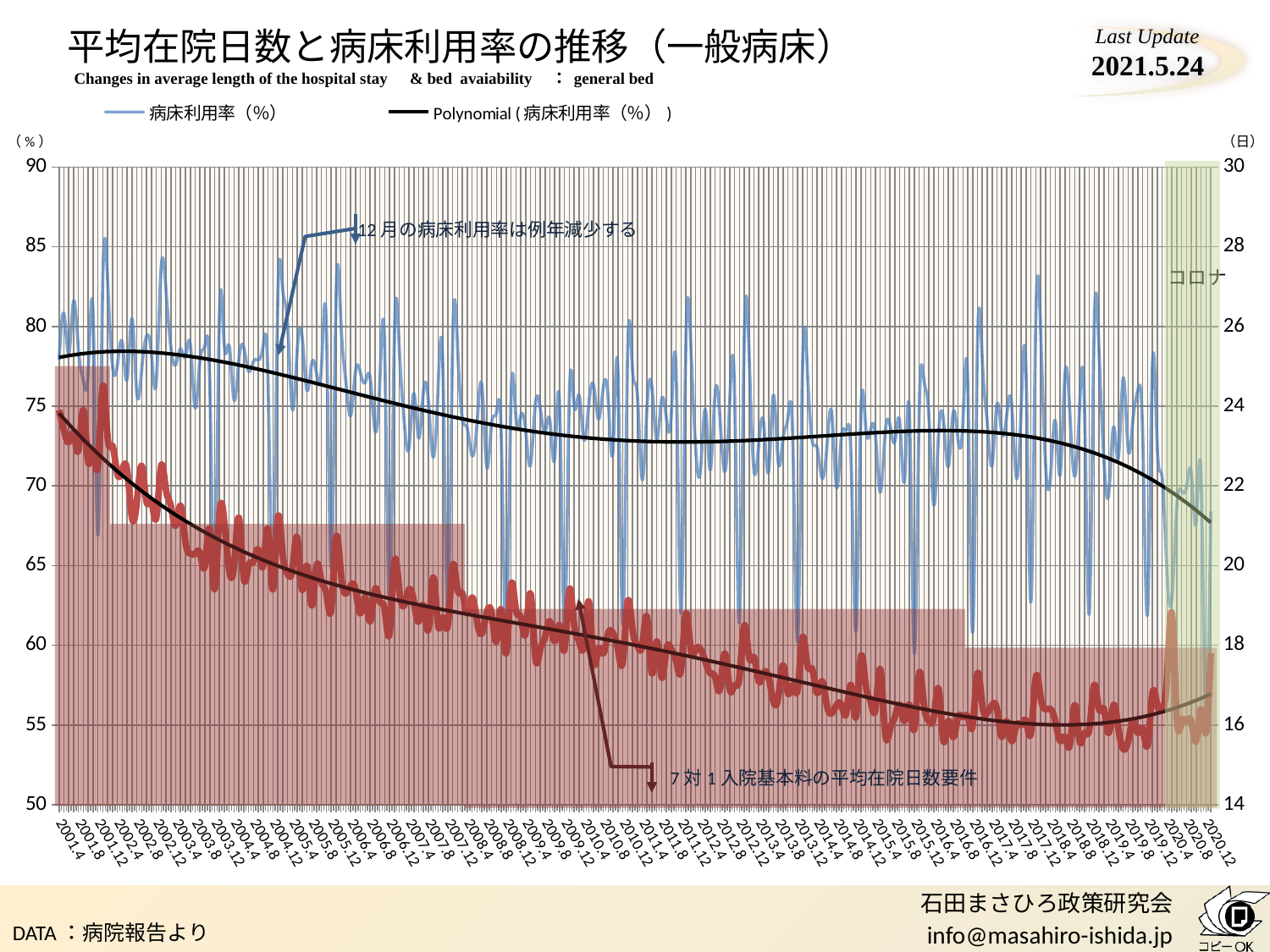
Does the black polynomial trend line for 病床利用率 rise or fall overall from 2001 to 2020? fall Is the 病床利用率 value at 2001.4 greater or less than 75? greater What kind of chart is shown on the slide? line chart What are the two entries in the chart legend? 病床利用率（%） and Polynomial (病床利用率（%）) What is the title of the chart? 平均在院日数と病床利用率の推移（一般病床） What is the maximum value shown on the left (%) axis? 90 Is the average length of stay (red line, right axis) at 2001.4 greater or less than 22 days? greater Is the lowest 病床利用率 value in 2020 greater or less than 65? less Does the red line for average length of hospital stay rise or fall overall from 2001.4 to 2020.12? fall How many series does the legend list? 2